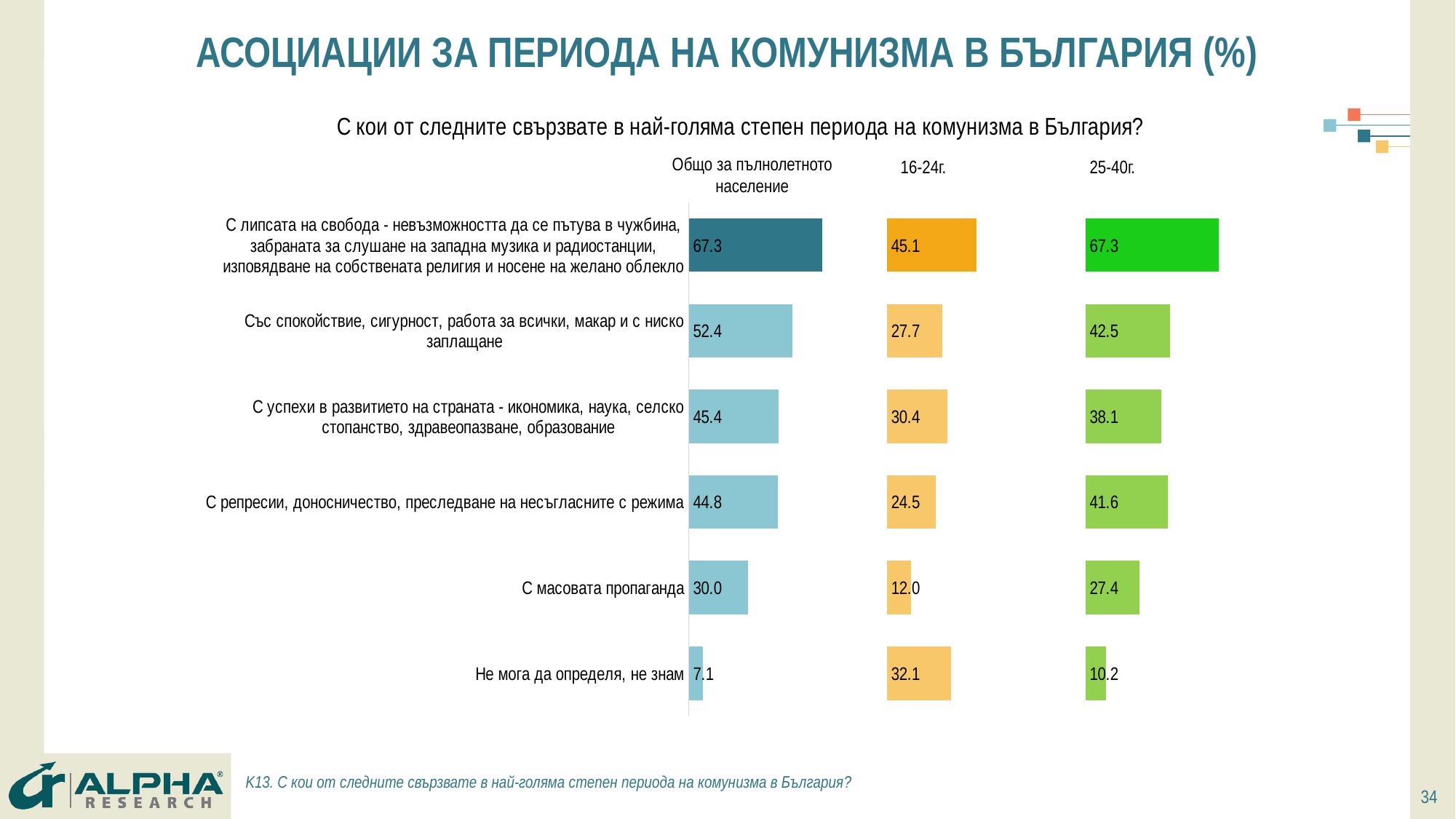
What is the difference between the "25-40г." value and the "16-24г." value for "С масовата пропаганда"? 15.4 In the "16-24г." chart, what is the value for "Не мога да определя, не знам"? 32.1 What is the difference between the "Общо за пълнолетното население" value and the "16-24г." value for "Със спокойствие, сигурност, работа за всички, макар и с ниско заплащане"? 24.7 How many age-group columns (charts) are shown on the slide? 3 In the "Общо за пълнолетното население" chart, what is the value for "С масовата пропаганда"? 30.0 In the "Общо за пълнолетното население" chart, which category has the highest value? С липсата на свобода - невъзможността да се пътува в чужбина, забраната за слушане на западна музика и радиостанции, изповядване на собствената религия и носене на желано облекло In the "16-24г." chart, which category has the lowest value? С масовата пропаганда For "С успехи в развитието на страната - икономика, наука, селско стопанство, здравеопазване, образование", which is larger: the "16-24г." value or the "25-40г." value? 25-40г. How many categories are shown in the "16-24г." chart? 6 In the "25-40г." chart, which category has the lowest value? Не мога да определя, не знам What kind of chart is used on this slide? Bar chart In the "25-40г." chart, what is the value for "С репресии, доносничество, преследване на несъгласните с режима"? 41.6